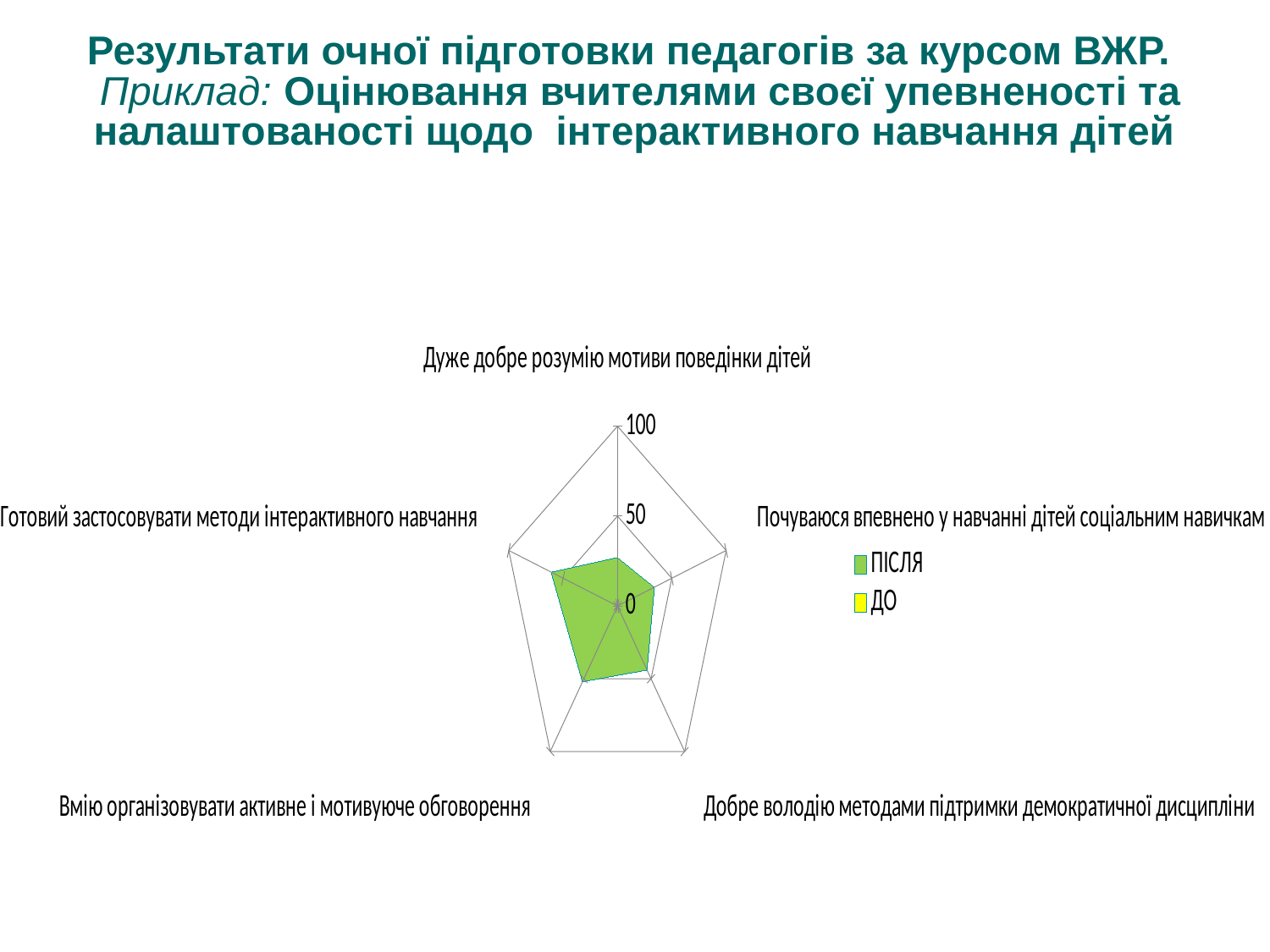
For the ПІСЛЯ series, which is larger: "Дуже добре розумію мотиви поведінки дітей" or "Вмію організовувати активне і мотивуюче обговорення"? Вмію організовувати активне і мотивуюче обговорення Is the ПІСЛЯ value for "Дуже добре розумію мотиви поведінки дітей" greater or less than 50? less What kind of chart is shown on the slide? radar chart What are the two series named in the legend? ПІСЛЯ and ДО What is the maximum value shown on the radar chart's axis scale? 100 For the ПІСЛЯ series, which is larger: "Дуже добре розумію мотиви поведінки дітей" or "Готовий застосовувати методи інтерактивного навчання"? Готовий застосовувати методи інтерактивного навчання What colour represents the series ПІСЛЯ? green How many categories (axes) does the radar chart have? 5 Which category has the lowest ПІСЛЯ value? Дуже добре розумію мотиви поведінки дітей Is the ПІСЛЯ value for "Почуваюся впевнено у навчанні дітей соціальним навичкам" greater or less than 50? less How many series does the legend list? 2 Is the ПІСЛЯ value for "Готовий застосовувати методи інтерактивного навчання" greater or less than 50? greater